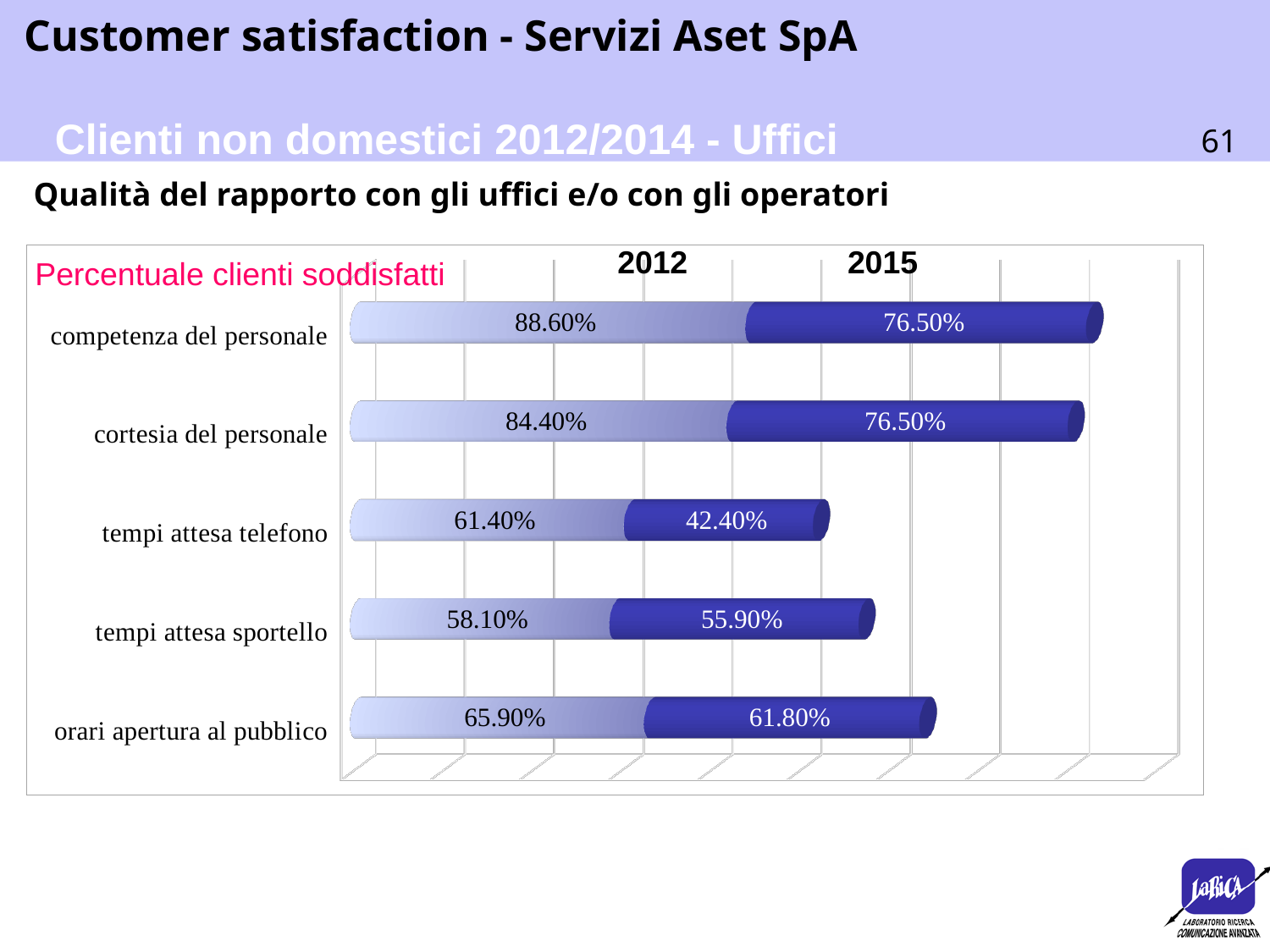
Which is larger for cortesia del personale, the 2012 value or the 2015 value? 2012 What type of chart is shown on the slide? bar chart How many categories are shown on the chart? 5 Which category has the lowest 2015 value? tempi attesa telefono What is the 2012 value for competenza del personale? 88.60% How many series does the chart show? 2 What is the difference between the 2012 values for competenza del personale and cortesia del personale? 4.20% What is the 2015 value for tempi attesa telefono? 42.40% What is the difference between the 2012 and 2015 values for tempi attesa telefono? 19.00% Which category has the highest 2012 value? competenza del personale What is the 2015 value for tempi attesa sportello? 55.90% What is the 2012 value for orari apertura al pubblico? 65.90%